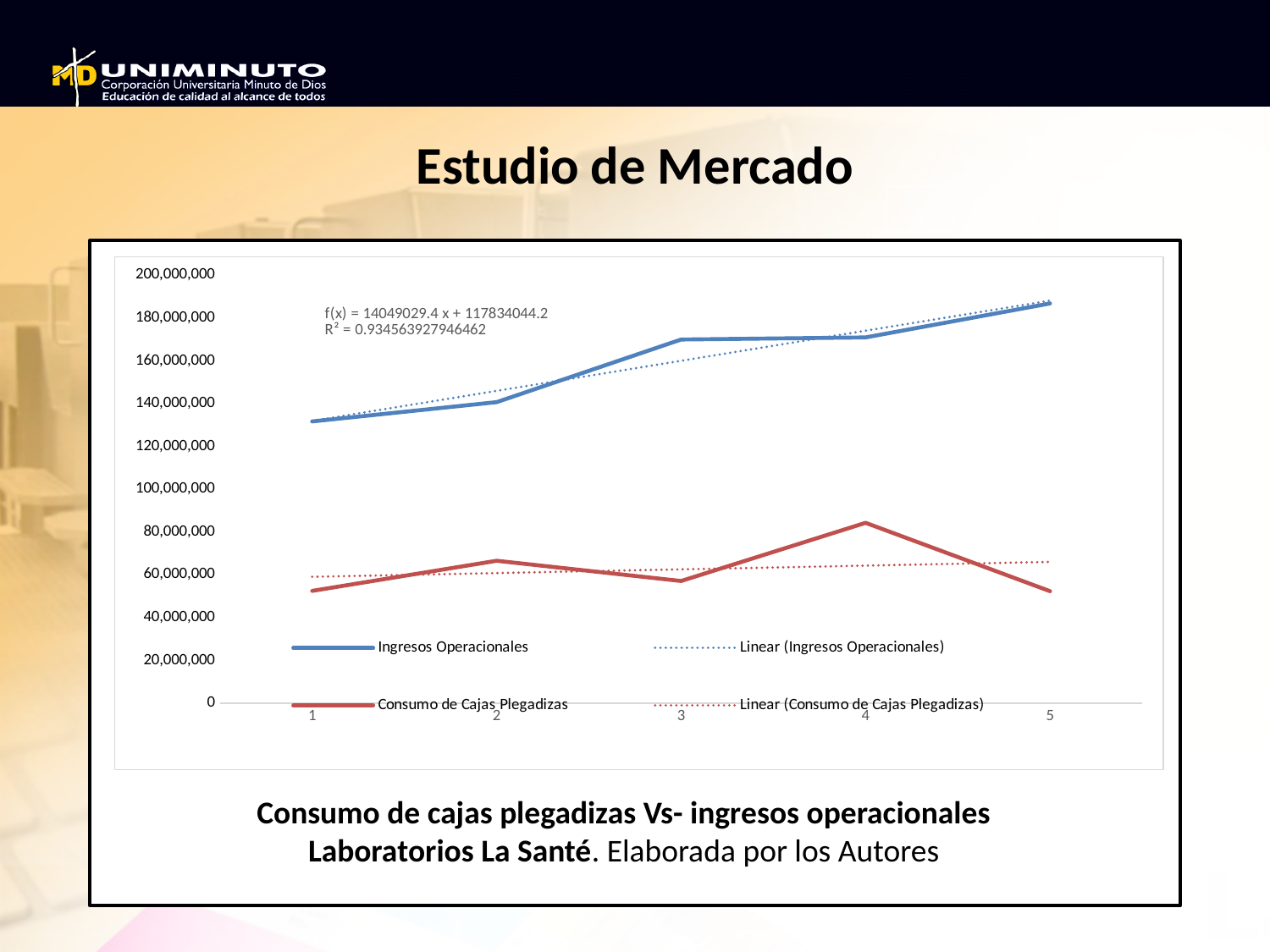
At which x-axis point is Ingresos Operacionales highest? 5 What kind of chart is shown on the slide? Line chart At which x-axis point is Ingresos Operacionales lowest? 1 How many points are plotted along the x axis for each series? 5 At which x-axis point is Consumo de Cajas Plegadizas highest? 4 Is the value for Ingresos Operacionales at point 5 greater or less than 180,000,000? greater Is the value for Ingresos Operacionales at point 1 greater or less than 140,000,000? less At point 3, which series has the larger value, Ingresos Operacionales or Consumo de Cajas Plegadizas? Ingresos Operacionales What trendline equation is printed on the chart? f(x) = 14049029.4 x + 117834044.2 Does the Ingresos Operacionales line generally rise or fall from point 1 to point 5? Rise Is the value for Consumo de Cajas Plegadizas at point 4 greater or less than 60,000,000? greater How many entries does the legend list? 4